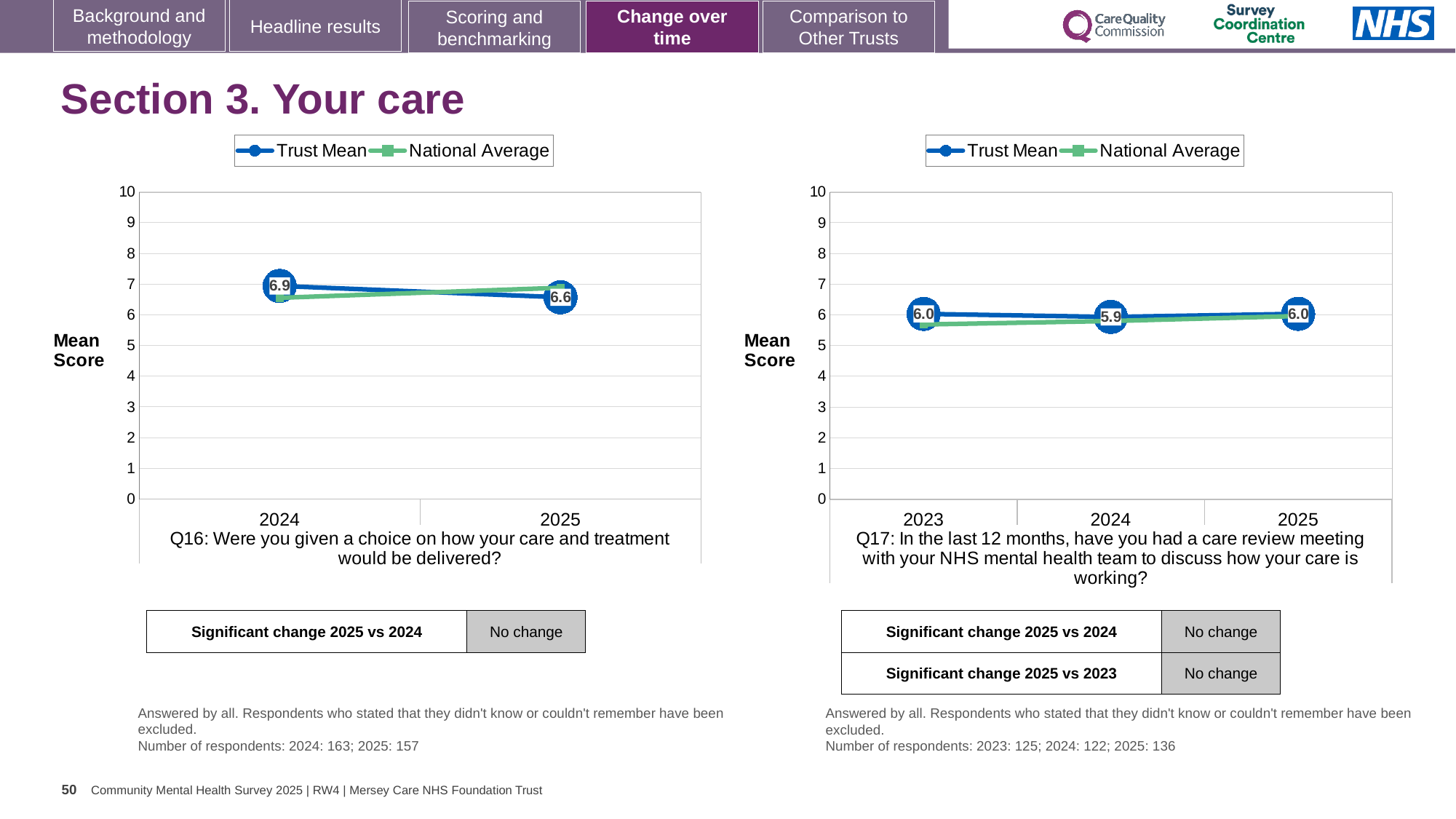
How many series does the legend of the Q16 chart on the left list? 2 In the Q17 chart on the right, which year has the lowest Trust Mean score? 2024 In the Q17 chart on the right, how many years are plotted on the x axis? 3 In the Q17 chart on the right, what is the Trust Mean score for 2024? 5.9 In the Q16 chart on the left, does the Trust Mean rise or fall from 2024 to 2025? fall In the Q16 chart on the left, what is the Trust Mean score for 2025? 6.6 In the Q16 chart on the left, what is the Trust Mean score for 2024? 6.9 In the Q16 chart on the left, is the National Average for 2024 greater or less than 7? less What type of chart is the Q17 chart on the right? line chart In the Q16 chart on the left, by how much did the Trust Mean fall from 2024 to 2025? 0.3 In the Q17 chart on the right, what is the Trust Mean score for 2025? 6.0 In the Q17 chart on the right, is the National Average for 2023 greater or less than 5? greater